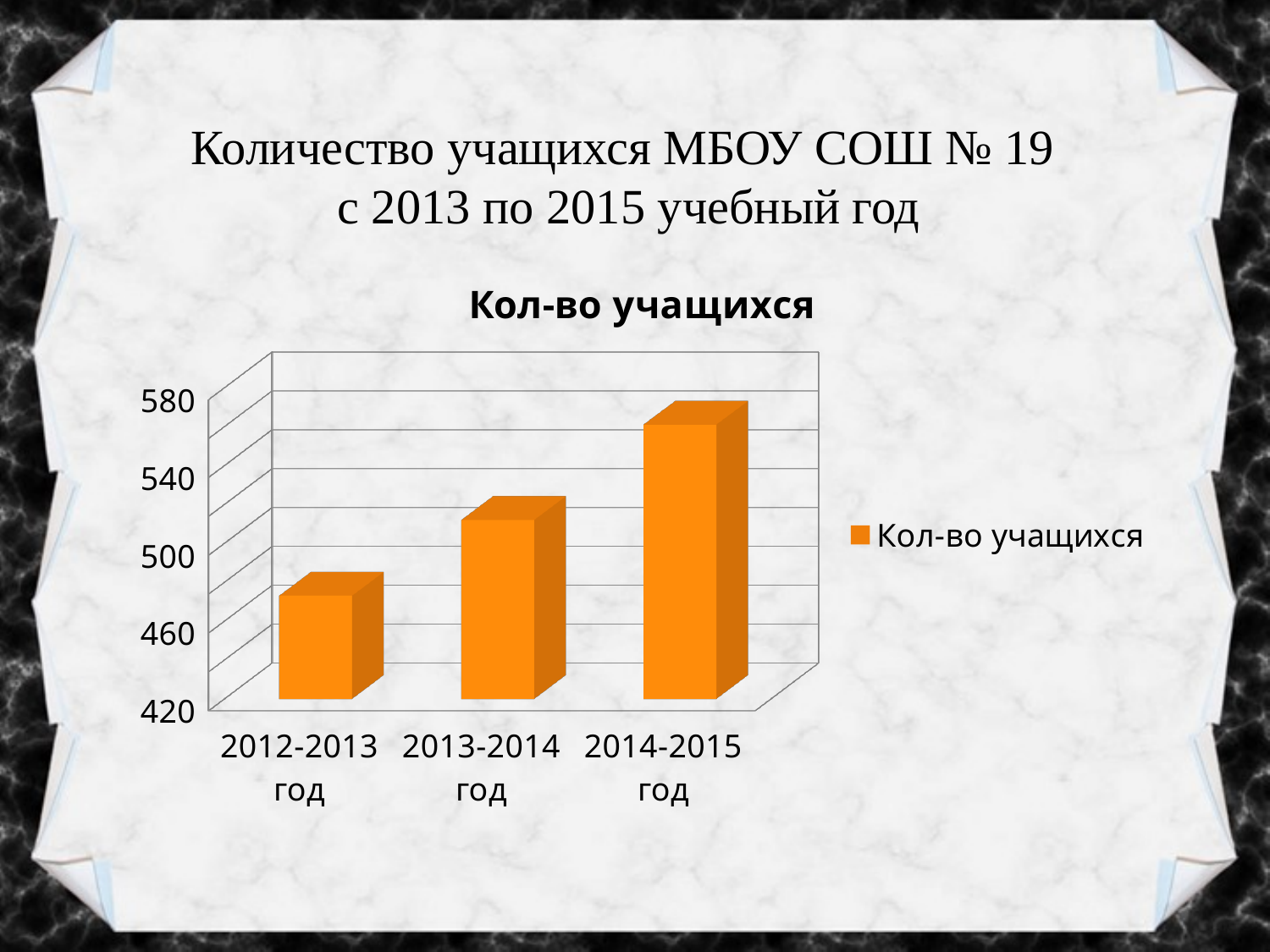
Is the value for 2013-2014 год greater or less than 500? greater What is the name of the series shown in the chart legend? Кол-во учащихся What kind of chart is shown on the slide? bar chart Which is larger: the value for 2013-2014 год or the value for 2012-2013 год? 2013-2014 год Which school year has the highest number of students in the chart? 2014-2015 год Which school year has the lowest number of students in the chart? 2012-2013 год How many categories (school years) are shown on the x axis of the chart? 3 How many series does the chart legend list? 1 What is the title of the chart? Кол-во учащихся Is the value for 2012-2013 год greater or less than 500? less Is the value for 2014-2015 год greater or less than 540? greater Do the values rise or fall from 2012-2013 to 2014-2015 along the x axis? rise